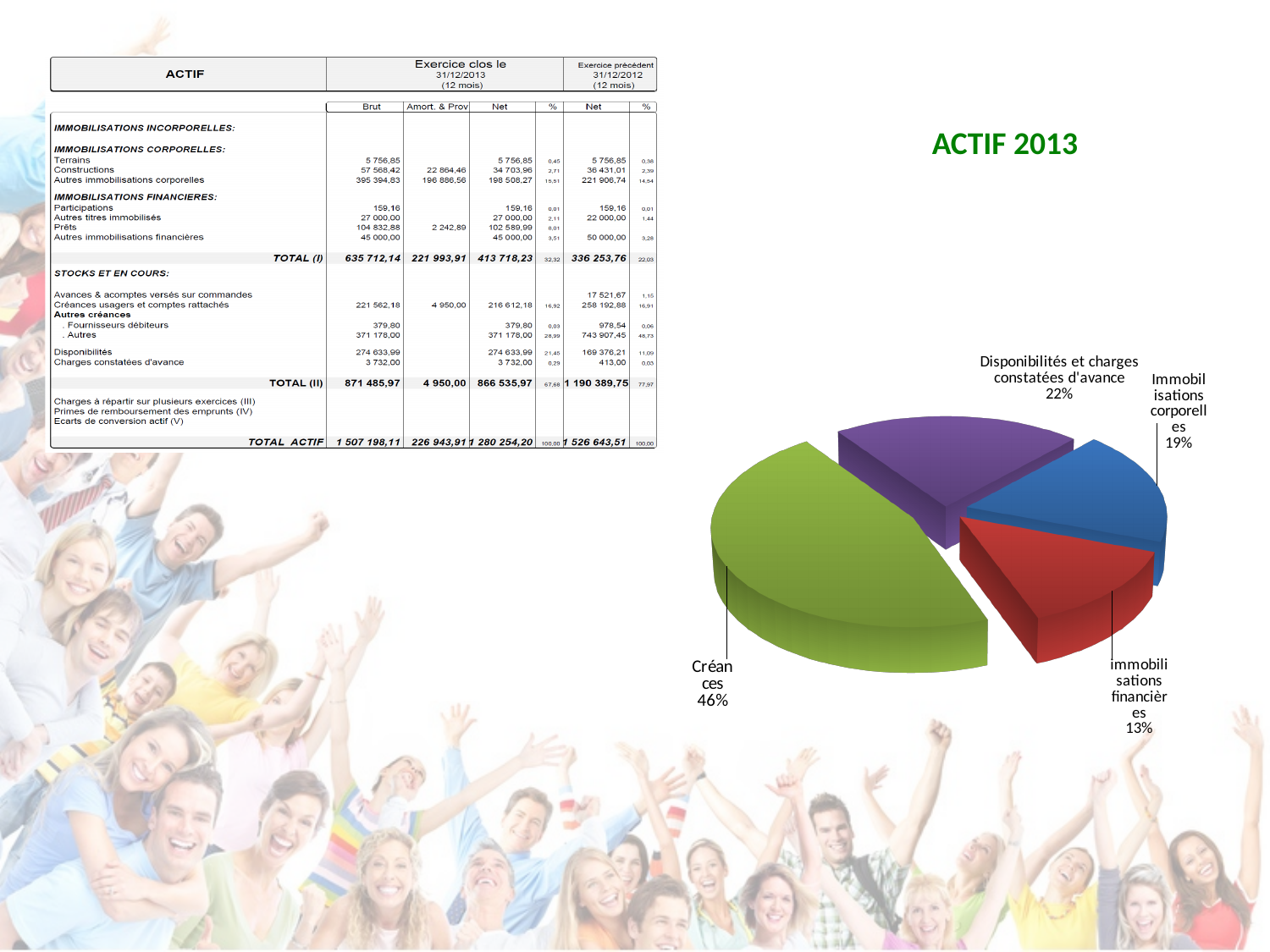
Which slice of the pie chart is the smallest? immobilisations financières What share of the pie chart is Créances? 46% What is the title of the pie chart? ACTIF 2013 What share of the pie chart is Disponibilités et charges constatées d'avance? 22% How many slices does the pie chart have? 4 What share of the pie chart is Immobilisations corporelles? 19% What colour is the Créances slice in the pie chart? Green Which slice of the pie chart is the largest? Créances What kind of chart is shown on the slide? Pie chart What is the difference in percentage points between Créances and Immobilisations corporelles? 27 Which is larger in the pie chart, Disponibilités et charges constatées d'avance or immobilisations financières? Disponibilités et charges constatées d'avance